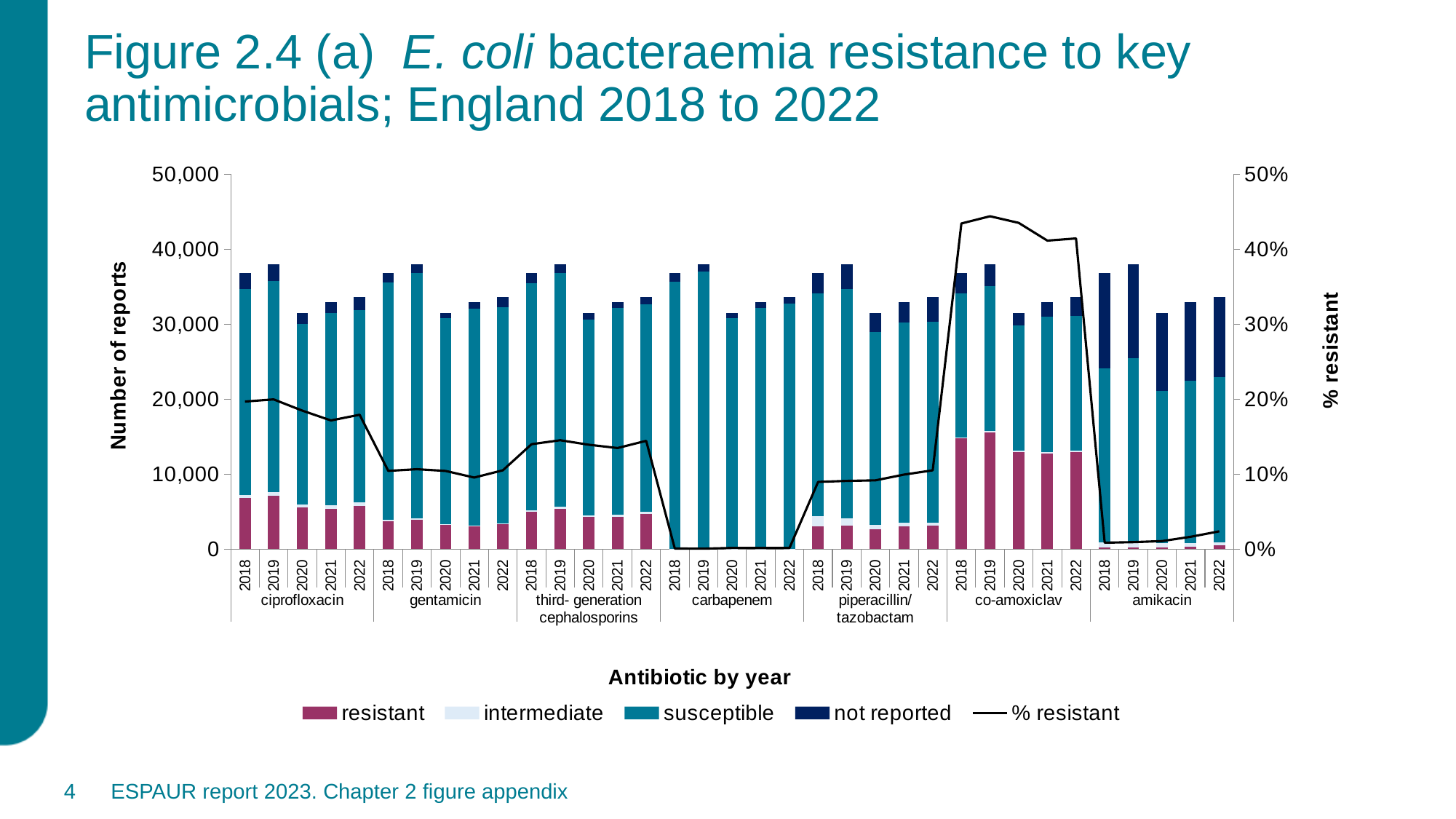
How many years are shown for each antibiotic? 5 How many antibiotic groups are shown along the x axis? 7 How many series does the legend list? 5 Is the % resistant value for co-amoxiclav in 2018 greater or less than 40%? greater Which antibiotic has the lowest % resistant line values? carbapenem Which antibiotic has the highest % resistant line values? co-amoxiclav What is the title of the left vertical axis? Number of reports What kind of chart is shown on the slide? Stacked bar chart with a line Does the % resistant line for ciprofloxacin rise or fall from 2018 to 2022? fall Is the % resistant value for amikacin in 2022 greater or less than 10%? less Which is larger, the resistant segment for co-amoxiclav in 2019 or the resistant segment for ciprofloxacin in 2019? co-amoxiclav 2019 Is the total number of reports for ciprofloxacin in 2019 greater or less than 35,000? greater